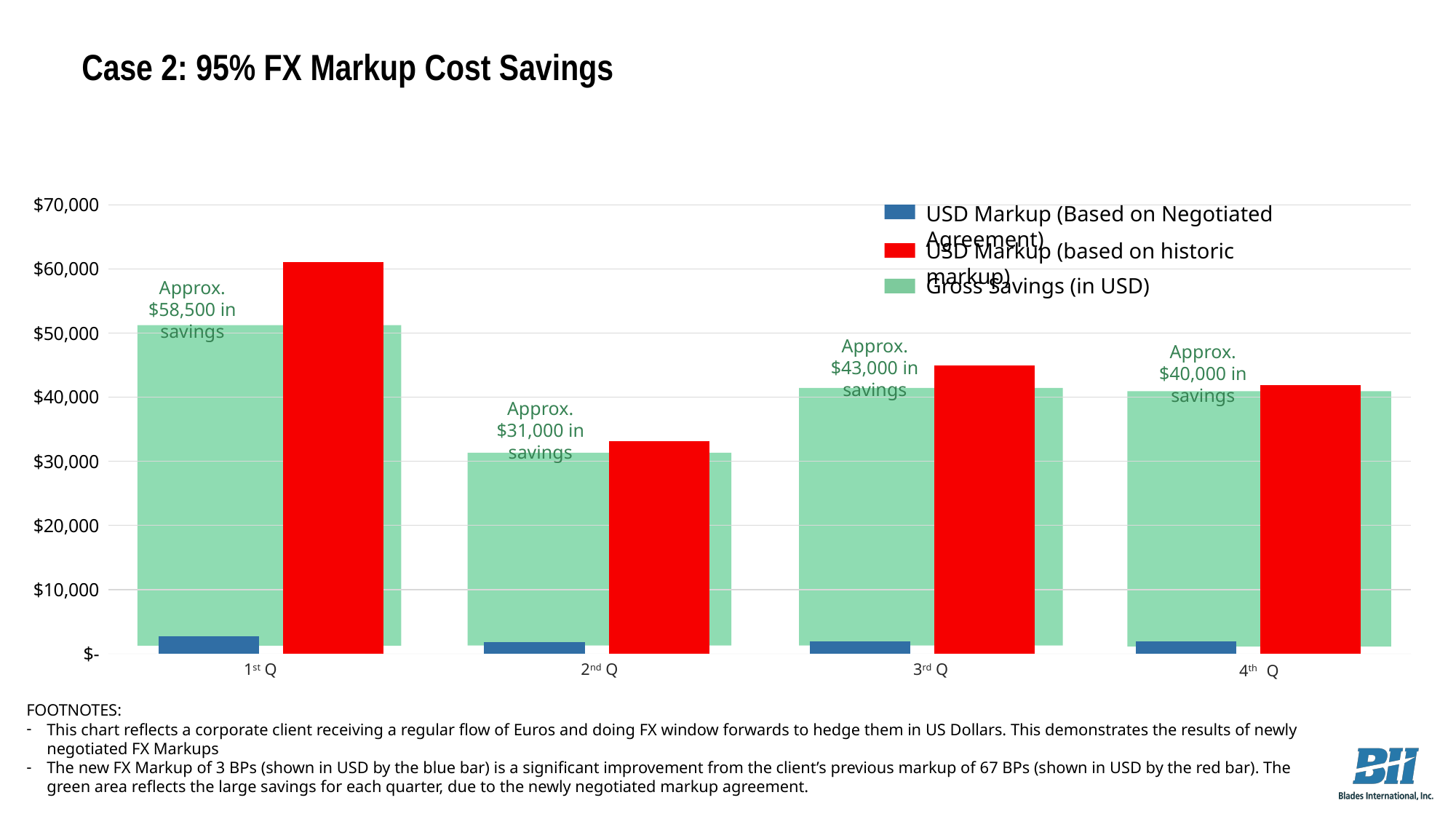
In which quarter is the USD Markup (based on historic markup) bar the highest? 1st Q What kind of chart is shown on the slide? bar chart Is the USD Markup (based on historic markup) value for 1st Q greater or less than $50,000? greater What colour represents Gross Savings (in USD) in the chart? green In which quarter is the Gross Savings (in USD) bar the lowest? 2nd Q Which is larger, the USD Markup (based on historic markup) value for 3rd Q or for 4th Q? 3rd Q How many series does the legend list? 3 Is the USD Markup (based on historic markup) value for 2nd Q greater or less than $40,000? less Does the USD Markup (based on historic markup) value rise or fall from 1st Q to 2nd Q? fall In which quarter is the USD Markup (based on historic markup) bar the lowest? 2nd Q Is the USD Markup (Based on Negotiated Agreement) value for 1st Q greater or less than $10,000? less How many quarters are shown on the x axis? 4